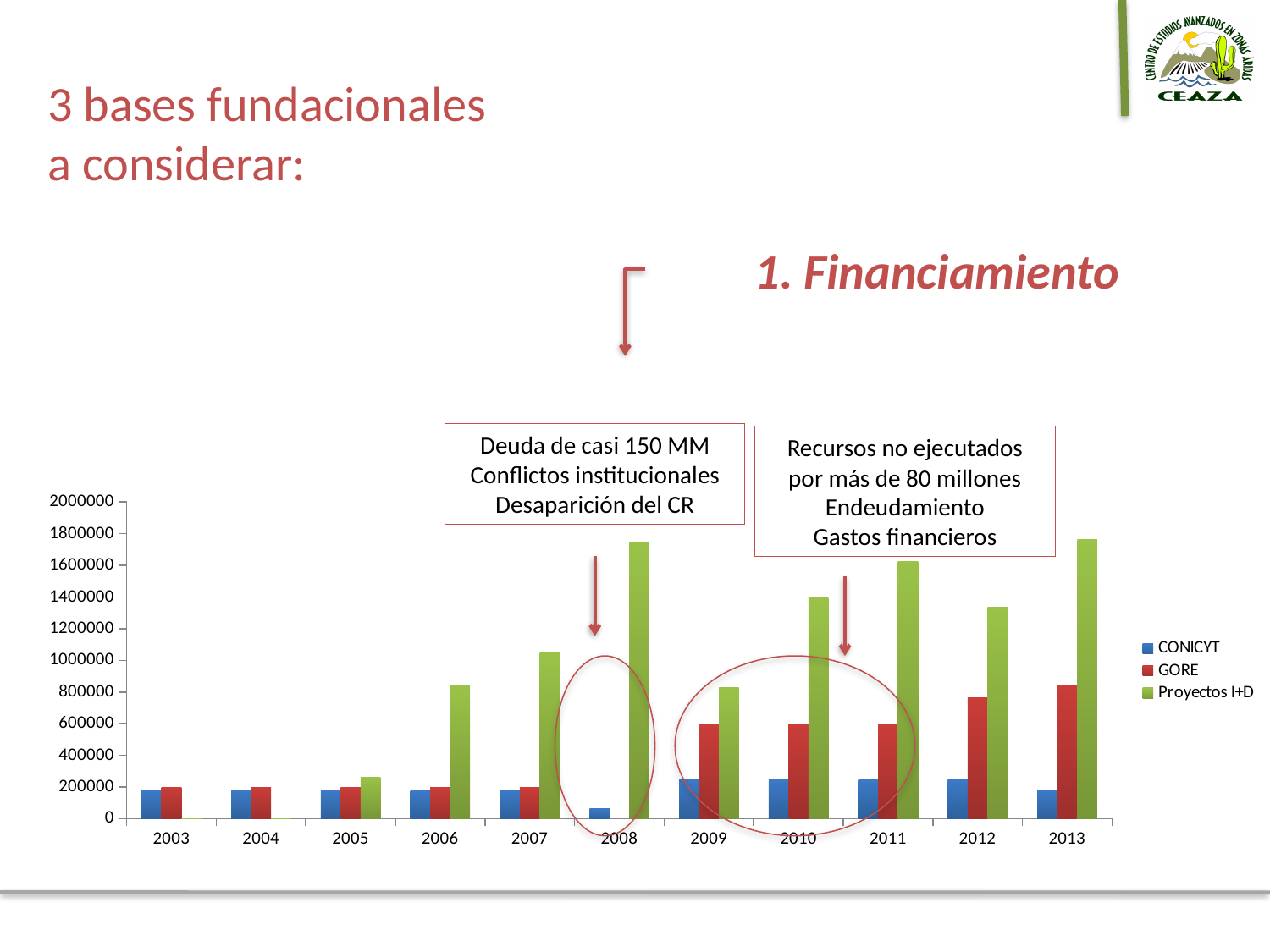
Which is larger, the Proyectos I+D value for 2009 or for 2010? 2010 How many series does the chart legend list? 3 Is the value for Proyectos I+D in 2006 greater or less than 1000000? less Which series is shown in green in the chart? Proyectos I+D Does the GORE value rise or fall from 2011 to 2013? rise What kind of chart is shown on the slide? bar chart What are the three series listed in the chart legend? CONICYT, GORE, Proyectos I+D Is the value for Proyectos I+D in 2008 greater or less than 1600000? greater Is the value for CONICYT in 2008 greater or less than 200000? less In which year is the GORE value highest? 2013 How many years are shown on the x axis of the chart? 11